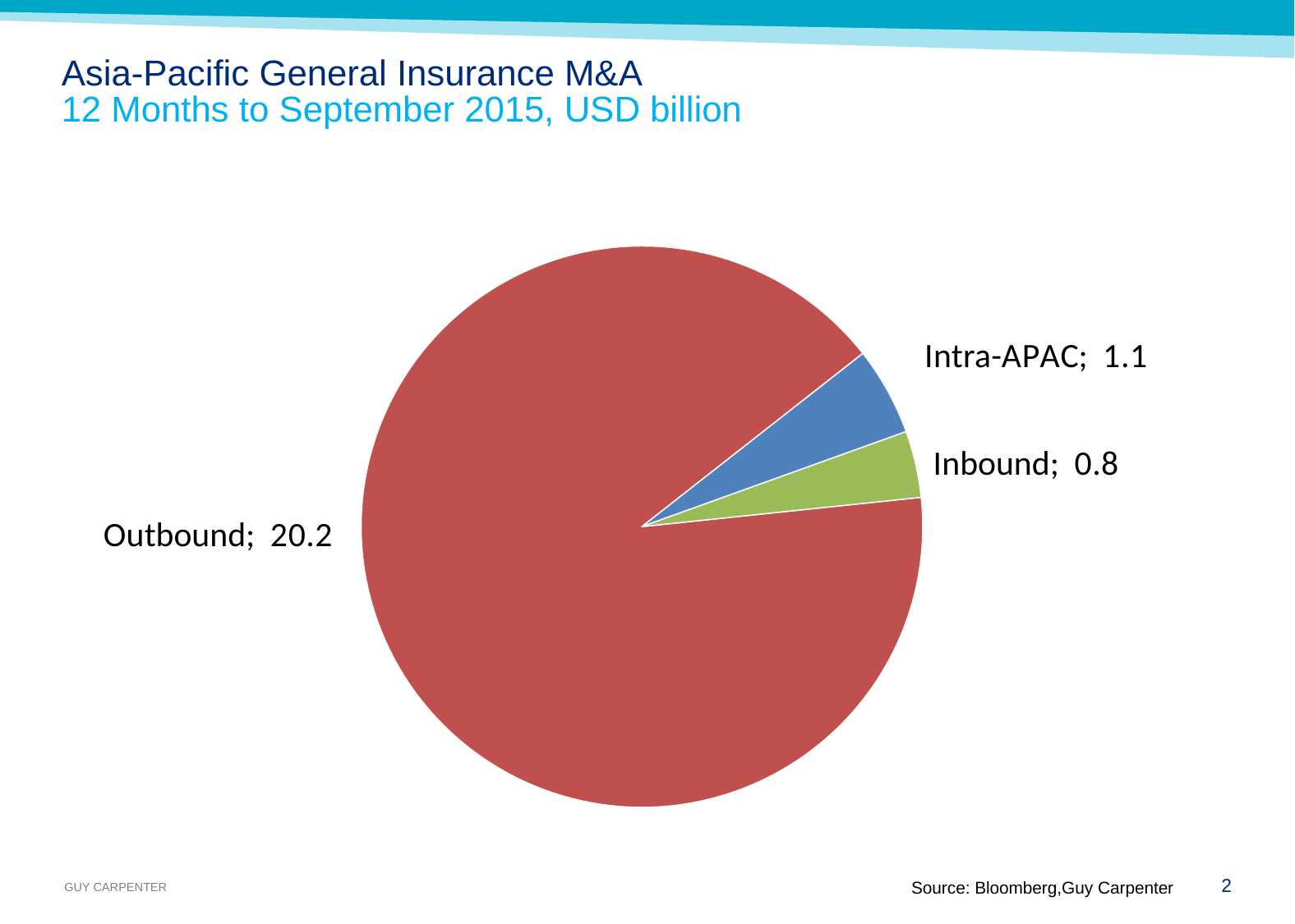
Which is larger, Intra-APAC or Inbound? Intra-APAC What is the difference between the Outbound value and the Intra-APAC value? 19.1 Which category has the largest slice of the pie chart? Outbound What is the value for Inbound in the pie chart? 0.8 What is the difference between the Intra-APAC value and the Inbound value? 0.3 Which category has the smallest slice of the pie chart? Inbound What unit are the values in the pie chart expressed in, according to the subtitle? USD billion What is the value for Outbound in the pie chart? 20.2 What is the total of all slices in the pie chart? 22.1 What is the value for Intra-APAC in the pie chart? 1.1 What kind of chart is shown on the slide? Pie chart How many categories are shown in the pie chart? 3